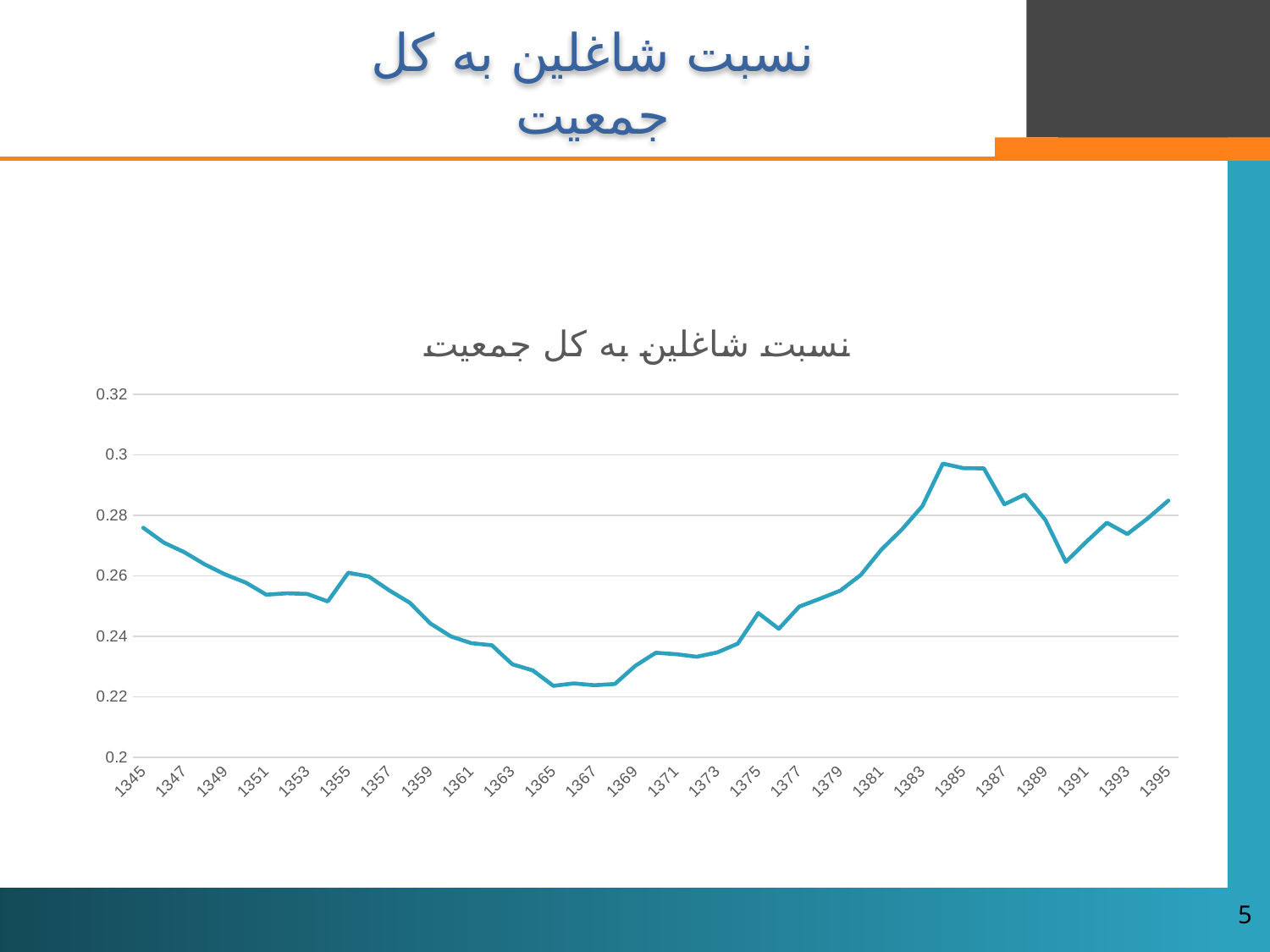
Is the value for 1375 greater or less than 0.26? less What kind of chart is shown on the slide? line chart Which is larger, the value for 1345 or the value for 1365? 1345 Is the value for 1365 greater or less than 0.24? less What is the highest value shown on the vertical axis of the chart? 0.32 Is the value for 1345 greater or less than 0.26? greater Does the line generally rise or fall between 1345 and 1365? fall Which is larger, the value for 1385 or the value for 1345? 1385 What is the title of the chart? نسبت شاغلین به کل جمعیت Does the line generally rise or fall between 1365 and 1385? rise